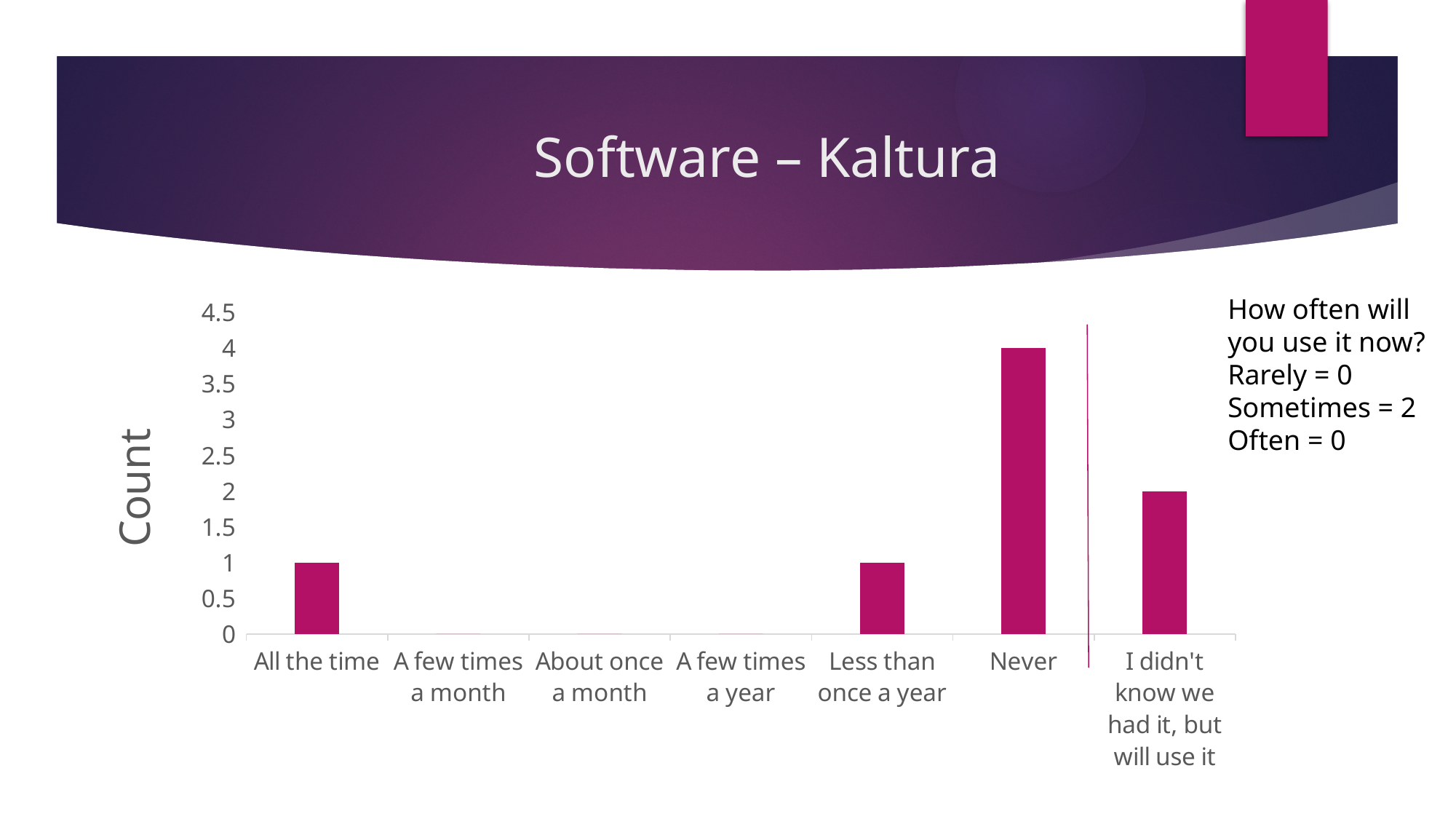
What type of chart is shown on the slide? bar chart What is the label on the y axis? Count How many categories are shown on the x axis? 7 What is the count for "All the time"? 1 Which category has the highest count? Never What is the count for "Never"? 4 Is the count for "Never" greater or less than 3? greater Which is larger, the count for "Never" or the count for "All the time"? Never What is the difference between the count for "Never" and the count for "I didn't know we had it, but will use it"? 2 What is the count for "Less than once a year"? 1 What is the count for "I didn't know we had it, but will use it"? 2 What is the title of the slide containing the chart? Software – Kaltura